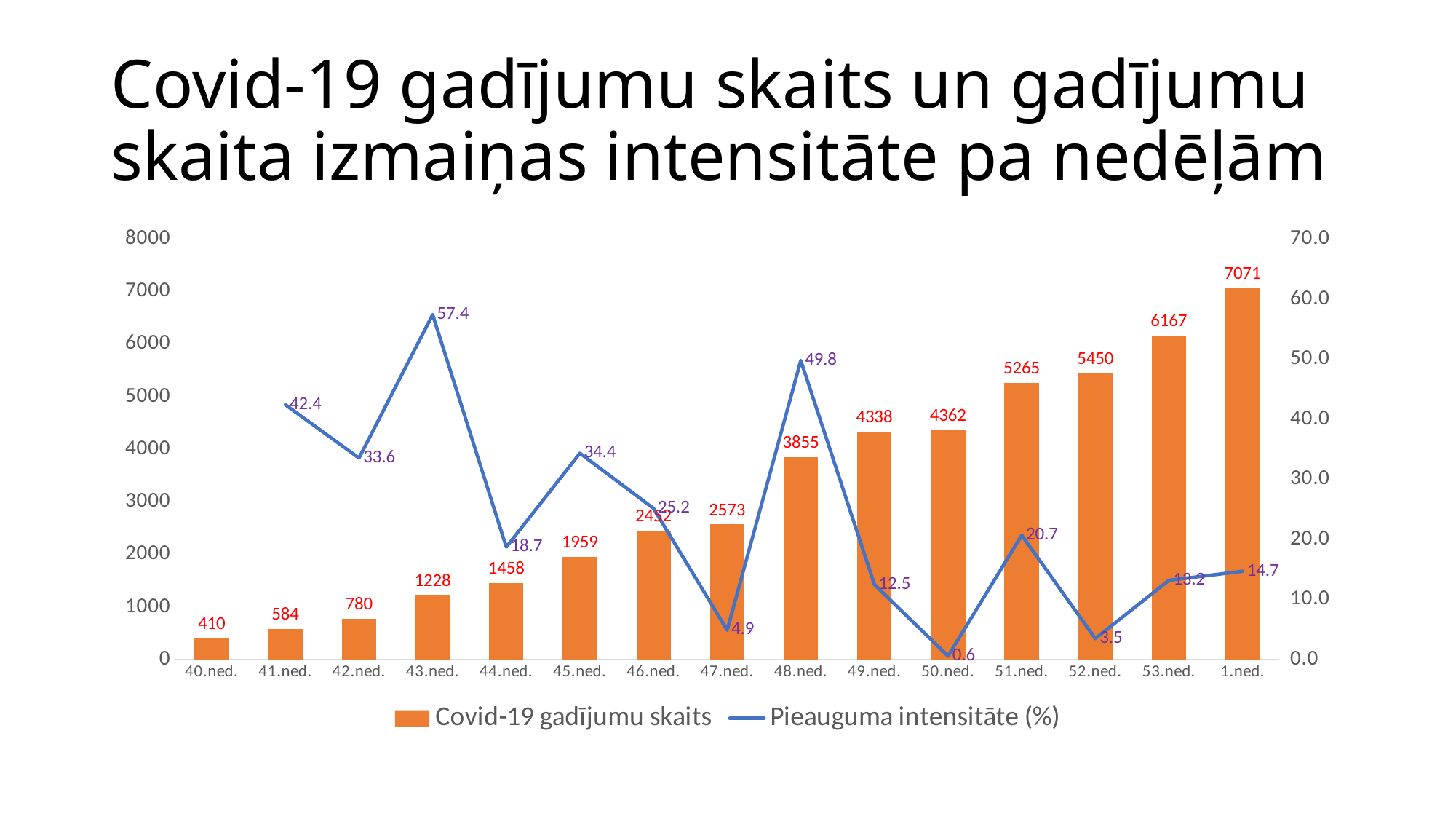
What colour are the Covid-19 gadījumu skaits bars? Orange Do the Covid-19 gadījumu skaits bars rise or fall from 40.ned. to 1.ned.? Rise Which week has the highest Covid-19 gadījumu skaits? 1.ned. What is the Covid-19 gadījumu skaits value for 45.ned.? 1959 What is the Pieauguma intensitāte (%) value for 43.ned.? 57.4 How many weeks are shown on the x axis? 15 Is the Covid-19 gadījumu skaits for 48.ned. greater or less than 3000? greater Which is larger, the Pieauguma intensitāte (%) for 48.ned. or for 41.ned.? 48.ned. What kind of chart is shown on the slide? Combined bar and line chart How many series does the legend list? 2 Which week has the lowest Pieauguma intensitāte (%)? 50.ned. What is the difference in Covid-19 gadījumu skaits between 53.ned. and 52.ned.? 717